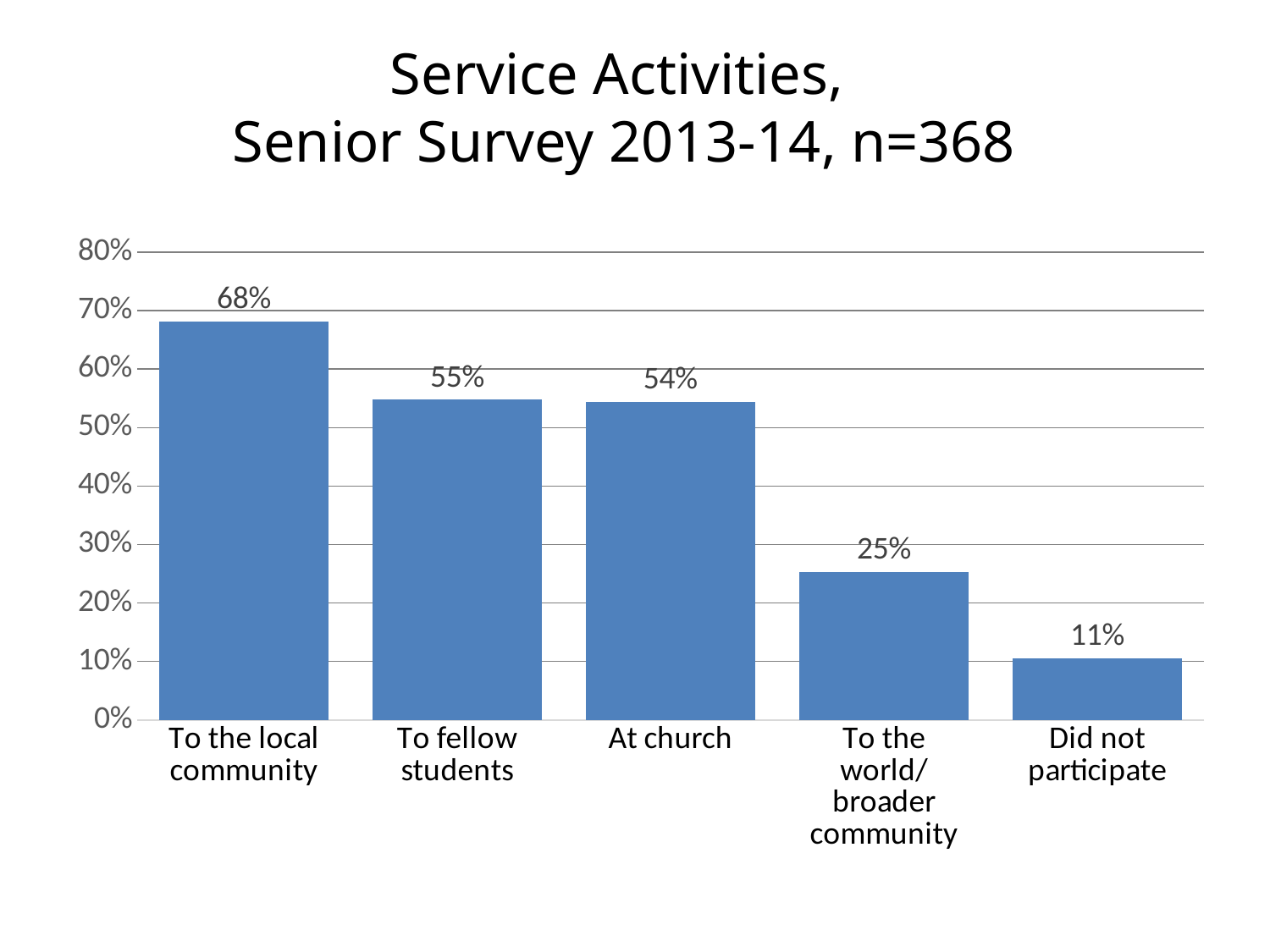
What percentage of seniors did not participate in service activities? 11% Which category has the highest value? To the local community Is the value for 'To the world/broader community' greater or less than 30%? less How many categories are shown on the chart? 5 What percentage of seniors reported service activities to the local community? 68% Do the values rise or fall from left to right across the categories? Fall Which category has the lowest value? Did not participate Which is larger: 'To fellow students' or 'To the world/broader community'? To fellow students What kind of chart is shown on the slide? Bar chart What is the sample size (n) given in the chart title? 368 What is the value for 'At church'? 54% What is the difference between 'To the local community' and 'To the world/broader community'? 43 percentage points